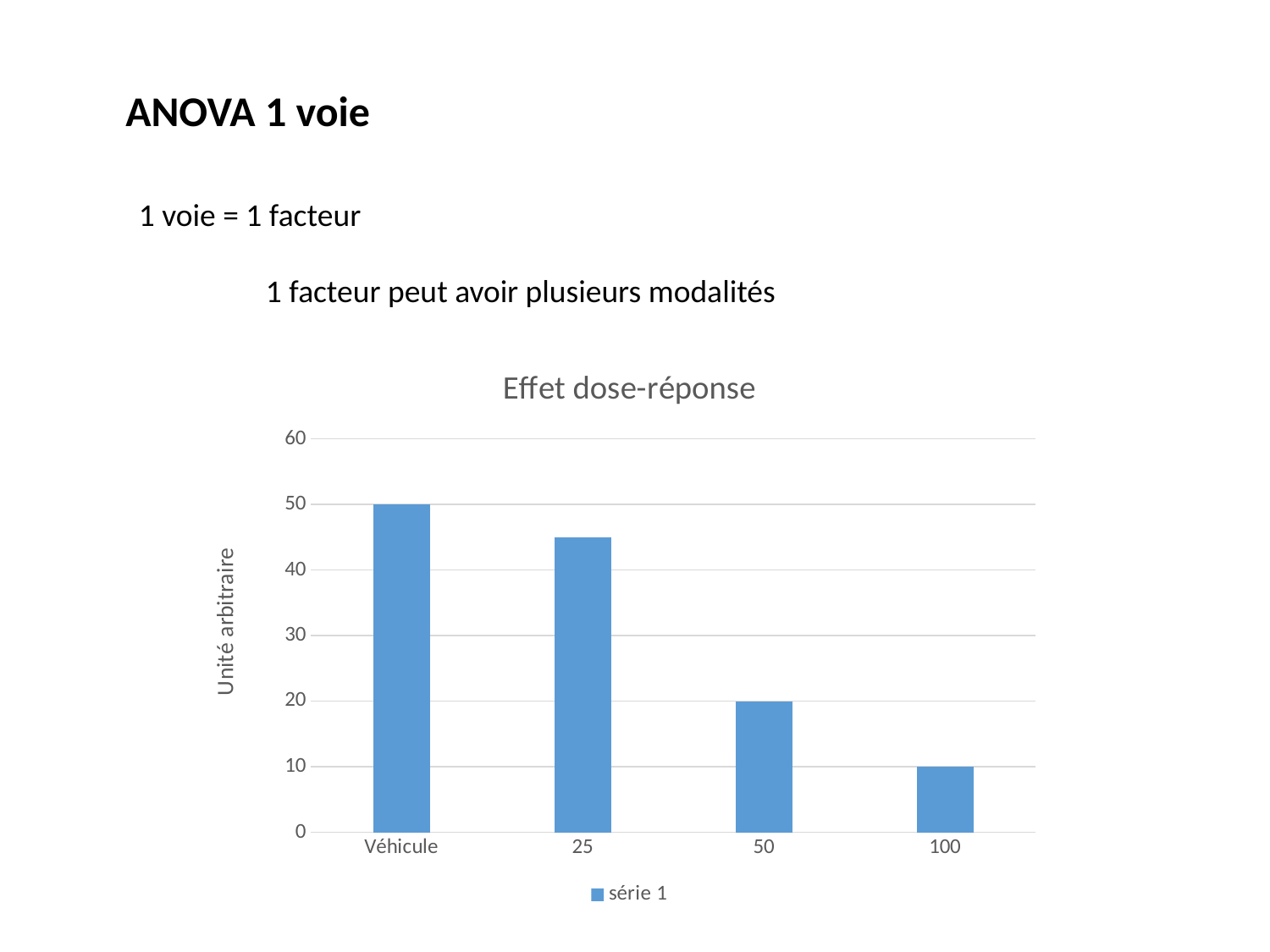
What is the value for the category 50? 20 Is the value for the category 25 greater or less than 40? greater What is the value for the category 100? 10 How many categories are shown on the x axis of the chart? 4 Do the values rise or fall from left to right along the x axis? fall What is the value for Véhicule? 50 Which category has the lowest value? 100 What is the title of the chart? Effet dose-réponse Which category has the highest value? Véhicule How many series does the legend list? 1 What is the difference between the value for Véhicule and the value for the category 50? 30 What kind of chart is shown on the slide? bar chart